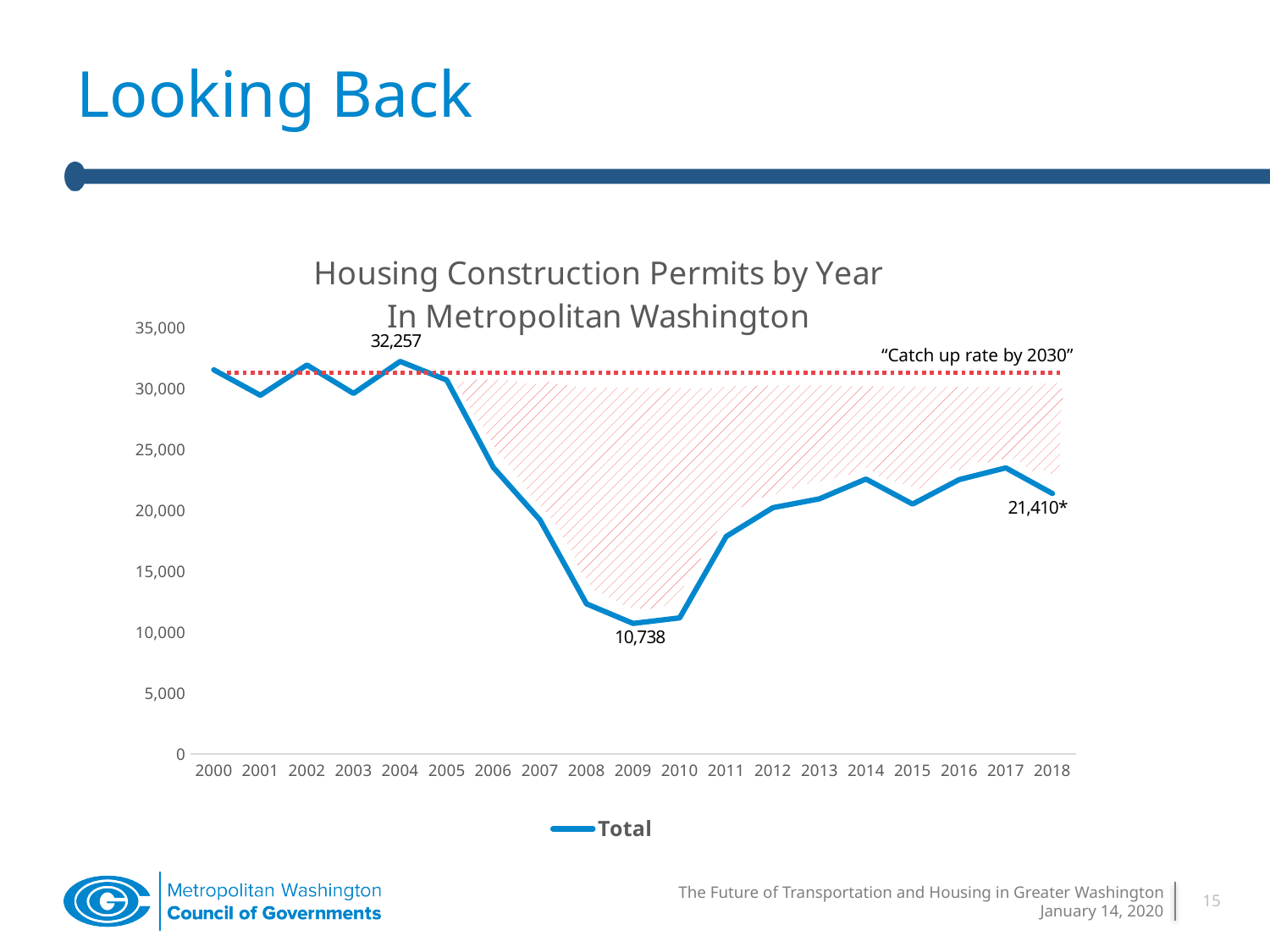
What label is given to the red dotted horizontal line in the Housing Construction Permits by Year chart? "Catch up rate by 2030" What is the value for 2009 in the Housing Construction Permits by Year chart? 10,738 Which is larger in the Housing Construction Permits by Year chart, the value for 2004 or the value for 2018? 2004 What is the difference between the 2004 value and the 2009 value in the Housing Construction Permits by Year chart? 21,519 How many years are plotted on the x axis of the Housing Construction Permits by Year chart? 19 What kind of chart is the Housing Construction Permits by Year chart? line chart What is the value for 2004 in the Housing Construction Permits by Year chart? 32,257 What is the value labelled for 2018 in the Housing Construction Permits by Year chart? 21,410* Which year has the lowest value in the Housing Construction Permits by Year chart? 2009 Is the value for 2014 in the Housing Construction Permits by Year chart greater or less than 20,000? greater Is the value for 2007 in the Housing Construction Permits by Year chart greater or less than 20,000? less Which year has the highest value in the Housing Construction Permits by Year chart? 2004